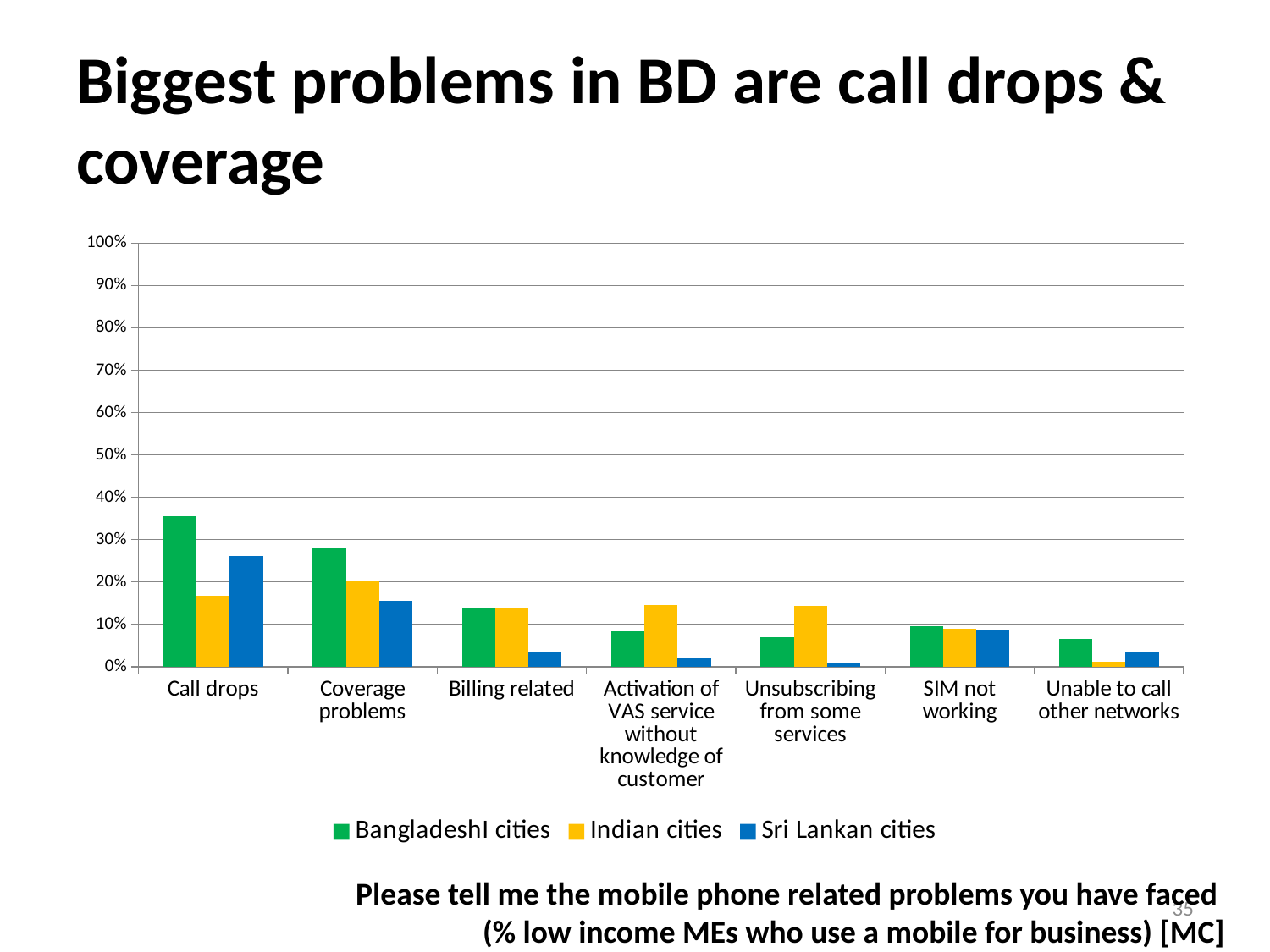
For Activation of VAS service without knowledge of customer, which is larger: Indian cities or Bangladeshi cities? Indian cities How many problem categories are shown on the x axis? 7 Is the value for Sri Lankan cities on Billing related greater or less than 10%? less What kind of chart is shown on the slide? Bar chart Which bar is the tallest in the whole chart? Bangladeshi cities, Call drops For Indian cities, which problem has the lowest value? Unable to call other networks Is the value for Sri Lankan cities on Call drops greater or less than 30%? less Is the value for Bangladeshi cities on Call drops greater or less than 30%? greater How many series does the legend list? 3 What colour represents Indian cities in the chart? Yellow For Call drops, which is larger: Bangladeshi cities or Sri Lankan cities? Bangladeshi cities For Bangladeshi cities, which problem has the highest value? Call drops